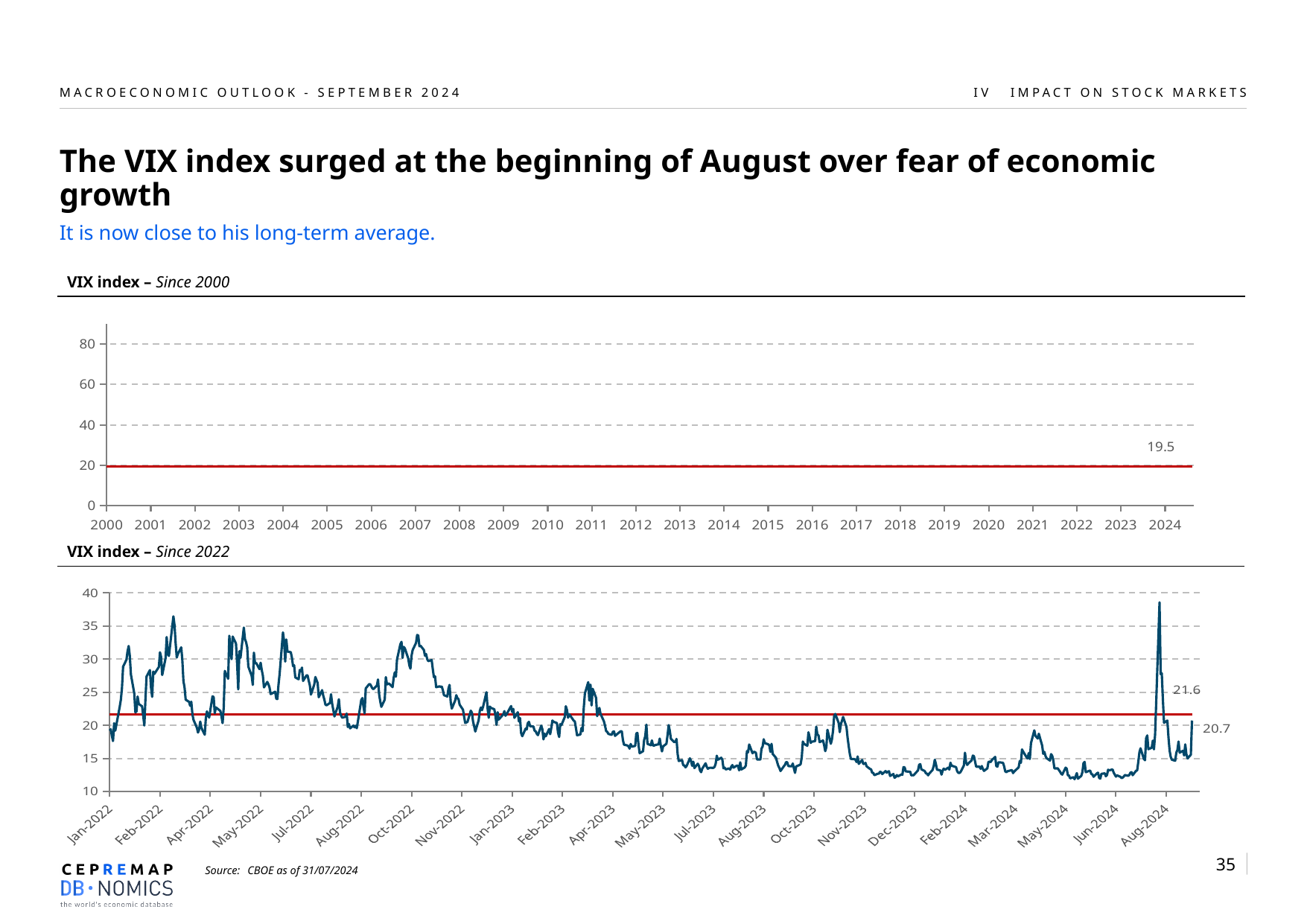
In the 'VIX index – Since 2000' chart, what value is labelled on the red horizontal line? 19.5 In the 'VIX index – Since 2022' chart, in which month does the VIX line reach its highest point? Aug-2024 In the 'VIX index – Since 2022' chart, is the peak value in Aug-2024 greater or less than 35? greater Which red line value is higher: the one in the 'Since 2000' chart or the one in the 'Since 2022' chart? the 'Since 2022' chart (21.6) In the 'VIX index – Since 2022' chart, what value is labelled on the red horizontal line? 21.6 In the 'VIX index – Since 2022' chart, is the VIX value around Dec-2023 greater or less than 15? less In the 'VIX index – Since 2022' chart, which is larger: the red line value or the last labelled VIX value? the red line value (21.6) In the 'VIX index – Since 2022' chart, what is the last value labelled at the end of the VIX line? 20.7 What type of chart is the 'VIX index – Since 2022' chart? line chart What is the highest value shown on the y axis of the 'VIX index – Since 2022' chart? 40 How many year labels are shown on the x axis of the 'VIX index – Since 2000' chart? 25 In the 'VIX index – Since 2022' chart, what is the difference between the red line value (21.6) and the last labelled VIX value (20.7)? 0.9